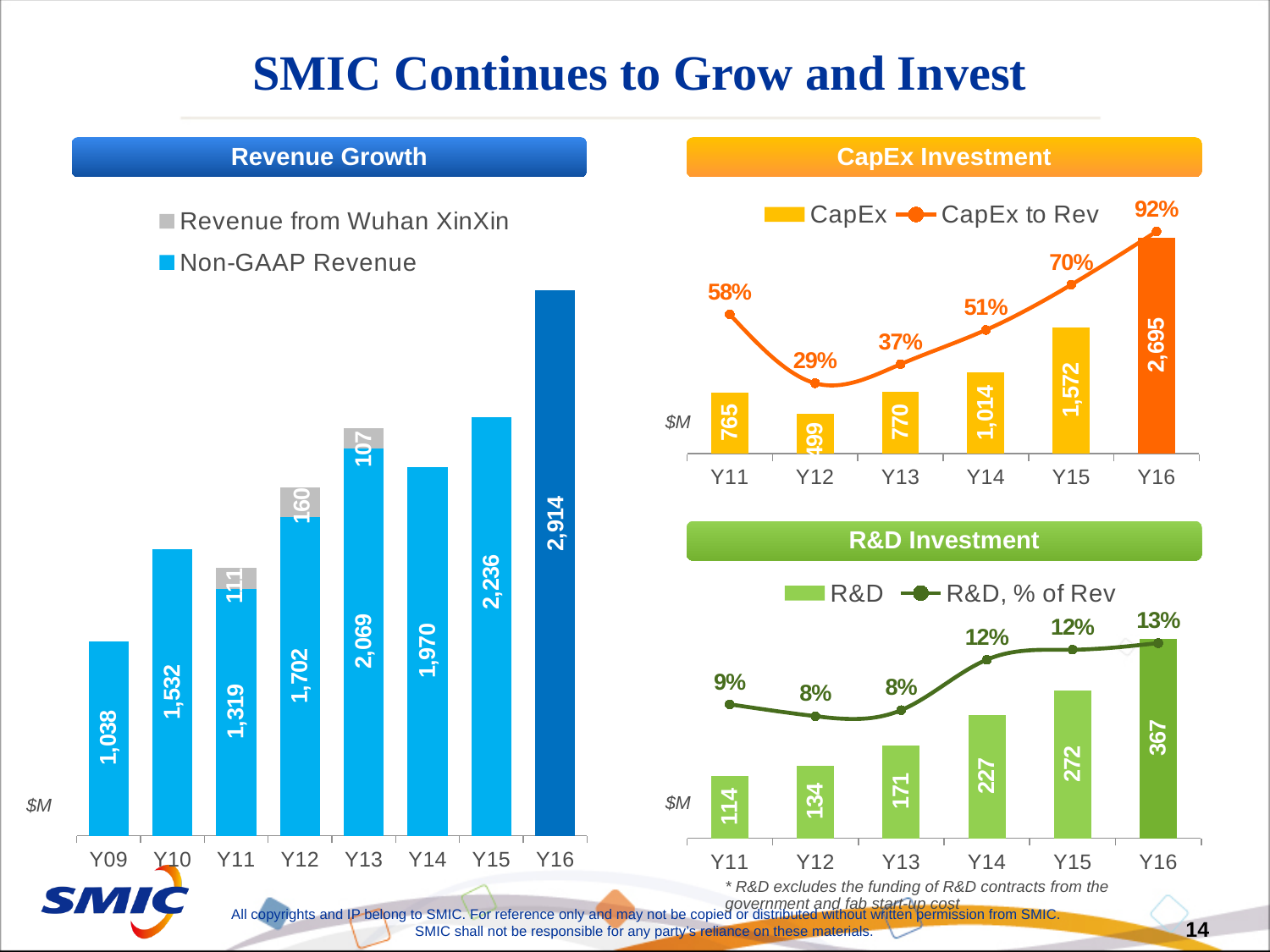
In the Revenue Growth chart, which is larger, the Non-GAAP Revenue for Y13 or for Y14? Y13 In the Revenue Growth chart, how many years are shown on the x axis? 8 In the CapEx Investment chart, what is the difference between the CapEx for Y16 and Y15? 1,123 In the CapEx Investment chart, which year has the lowest CapEx? Y12 In the Revenue Growth chart, what is the Non-GAAP Revenue for Y16? 2,914 In the R&D Investment chart, what is the R&D value for Y13? 171 In the R&D Investment chart, do the R&D bars rise or fall from Y11 to Y16? rise In the R&D Investment chart, which year has the highest R&D, % of Rev? Y16 In the R&D Investment chart, how many series does the legend list? 2 In the CapEx Investment chart, what is the CapEx to Rev value for Y14? 51% In the Revenue Growth chart, what is the Revenue from Wuhan XinXin for Y12? 160 In the Revenue Growth chart, what is the total of the stacked bar for Y12? 1,862